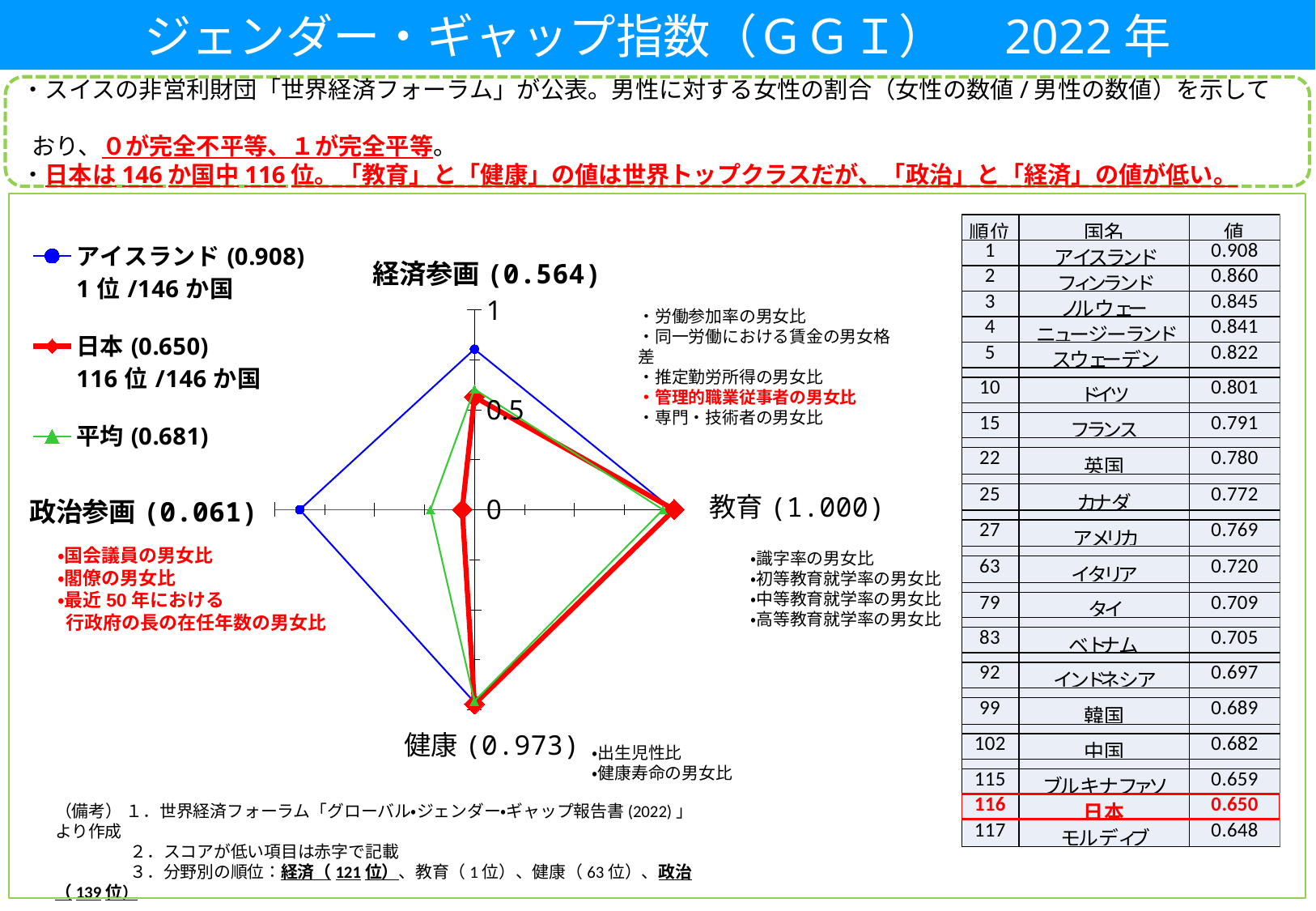
Which category has Japan's highest value on the radar chart? 教育 Is アイスランド's value for 経済参画 greater or less than 0.5? greater What is the difference between the overall scores of アイスランド and 日本 shown in the legend? 0.258 What is Japan's value for 政治参画 on the radar chart? 0.061 On the 政治参画 axis, which series has the larger value, アイスランド or 日本? アイスランド How many series does the radar chart's legend list? 3 What is Japan's value for 教育 on the radar chart? 1.000 What is Japan's value for 経済参画 on the radar chart? 0.564 Which category has Japan's lowest value on the radar chart? 政治参画 What is the difference between Japan's 健康 value and its 経済参画 value? 0.409 How many axes (categories) does the radar chart have? 4 What kind of chart is shown on the slide? Radar chart